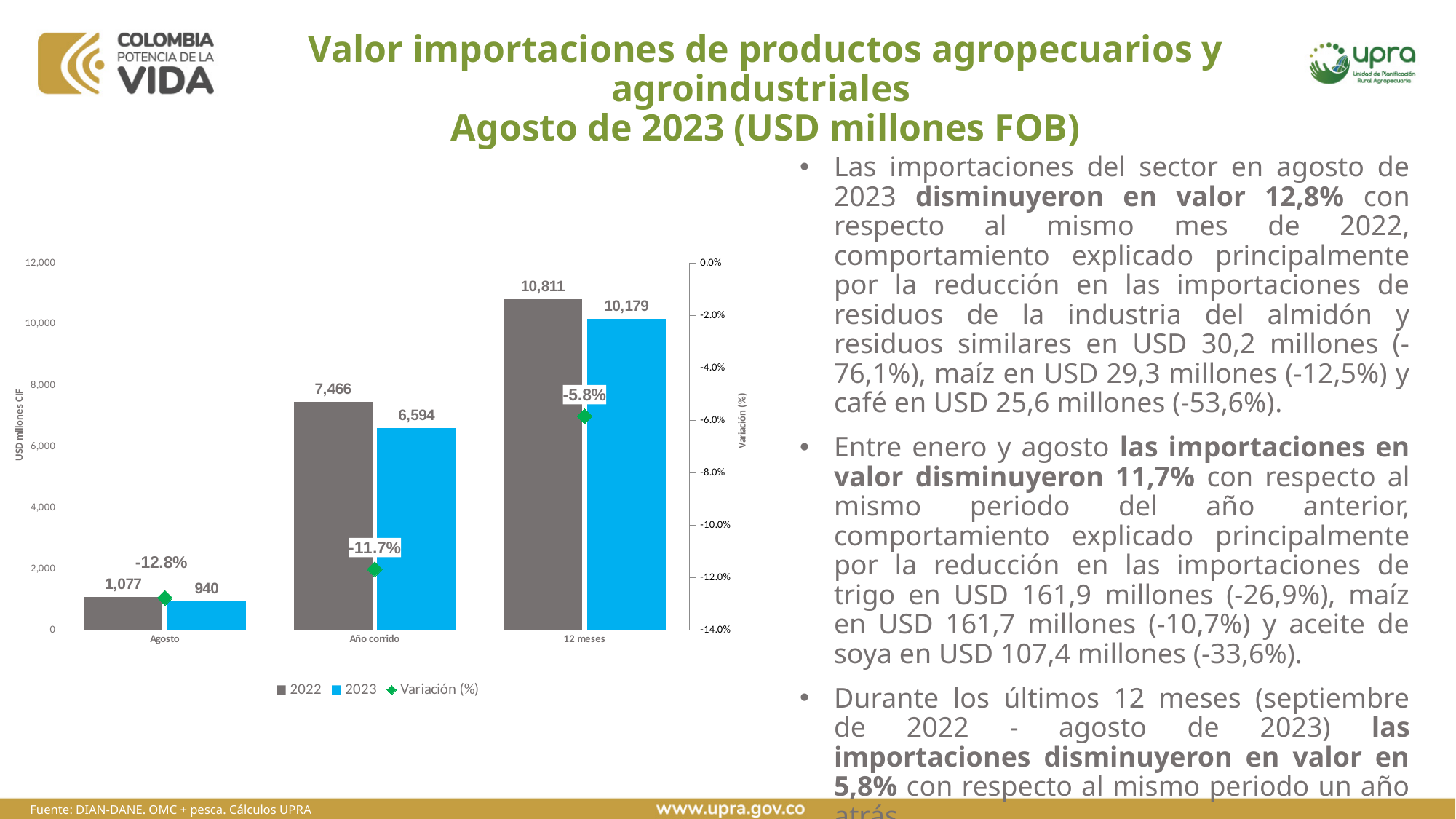
What is the 2022 value for Año corrido? 7,466 Which category has the lowest 2023 value? Agosto What is the label of the left vertical axis? USD millones CIF Which category has the highest 2022 value? 12 meses What is the difference between the 2022 and 2023 values for 12 meses? 632 What is the 2023 value for Agosto? 940 What is the 2023 value for 12 meses? 10,179 How many series does the legend list? 3 How many categories are shown on the x axis? 3 What kind of chart is shown on the slide? Bar chart with a line/marker series What is the Variación (%) value for Agosto? -12.8% Which is larger for Año corrido, the 2022 value or the 2023 value? 2022